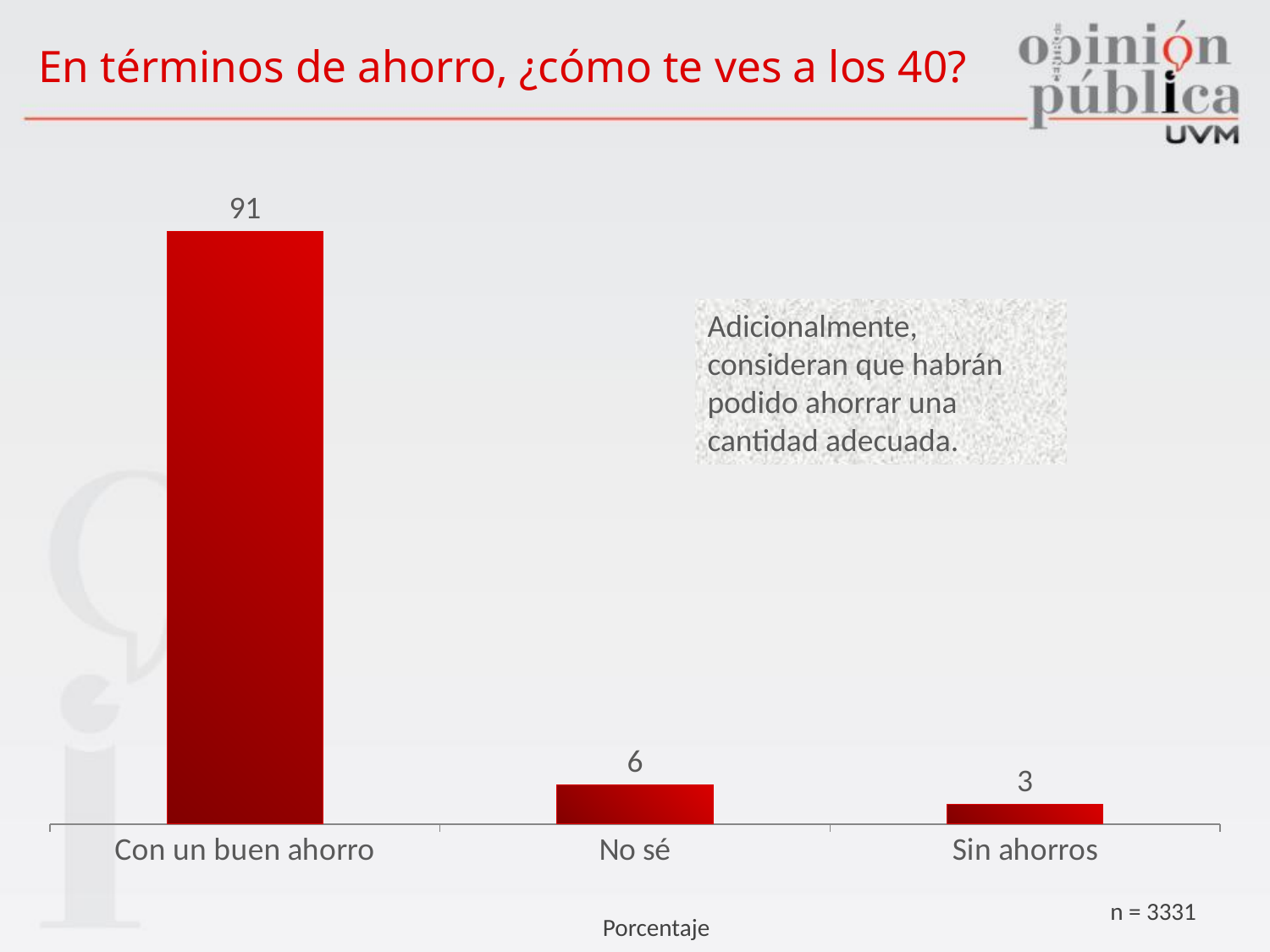
What is the x-axis label of the chart? Porcentaje What is the value for "Sin ahorros"? 3 What is the difference between the values for "Con un buen ahorro" and "No sé"? 85 What kind of chart is shown on the slide? Bar chart Which is larger, the value for "No sé" or the value for "Sin ahorros"? No sé What is the value for "No sé"? 6 Which category has the lowest value? Sin ahorros How many categories are shown in the chart? 3 Which category has the highest value? Con un buen ahorro Do the values rise or fall from left to right along the x axis? Fall What is the difference between the values for "No sé" and "Sin ahorros"? 3 What is the value for "Con un buen ahorro"? 91